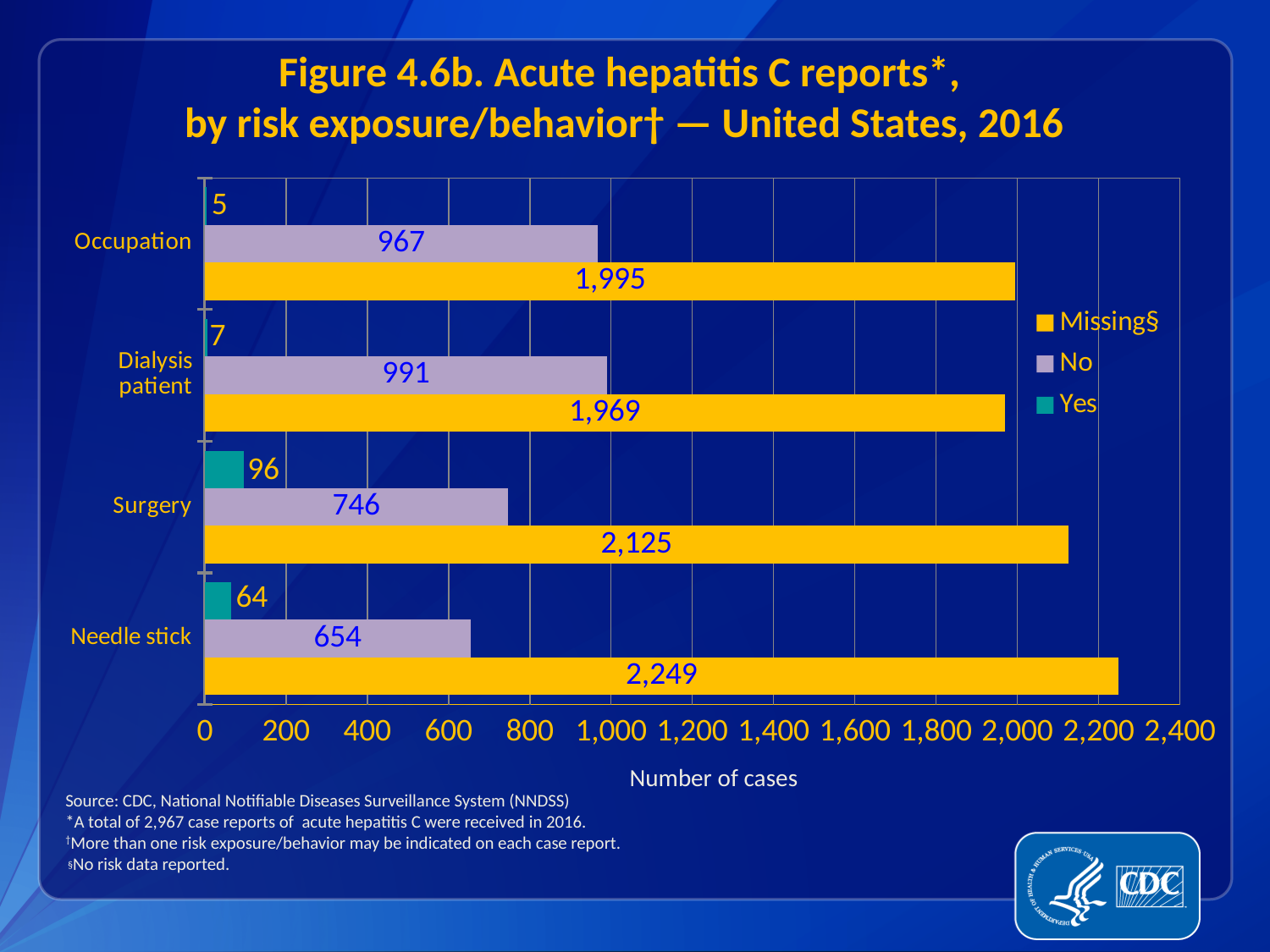
What is the difference between the No values for Dialysis patient and Surgery? 245 Which risk exposure/behavior has the lowest value in the Yes series? Occupation What kind of chart is shown on the slide? Bar chart What is the number of cases for Needle stick in the No series? 654 Which risk exposure/behavior has the highest value in the Missing§ series? Needle stick What is the number of cases for Occupation in the Missing§ series? 1,995 How many risk exposure/behavior categories are shown on the chart? 4 How many series does the legend list? 3 What is the label of the x axis? Number of cases Which is larger: the Missing§ value for Surgery or the Missing§ value for Dialysis patient? Surgery What is the number of cases for Dialysis patient in the Yes series? 7 What is the number of cases for Surgery in the Yes series? 96